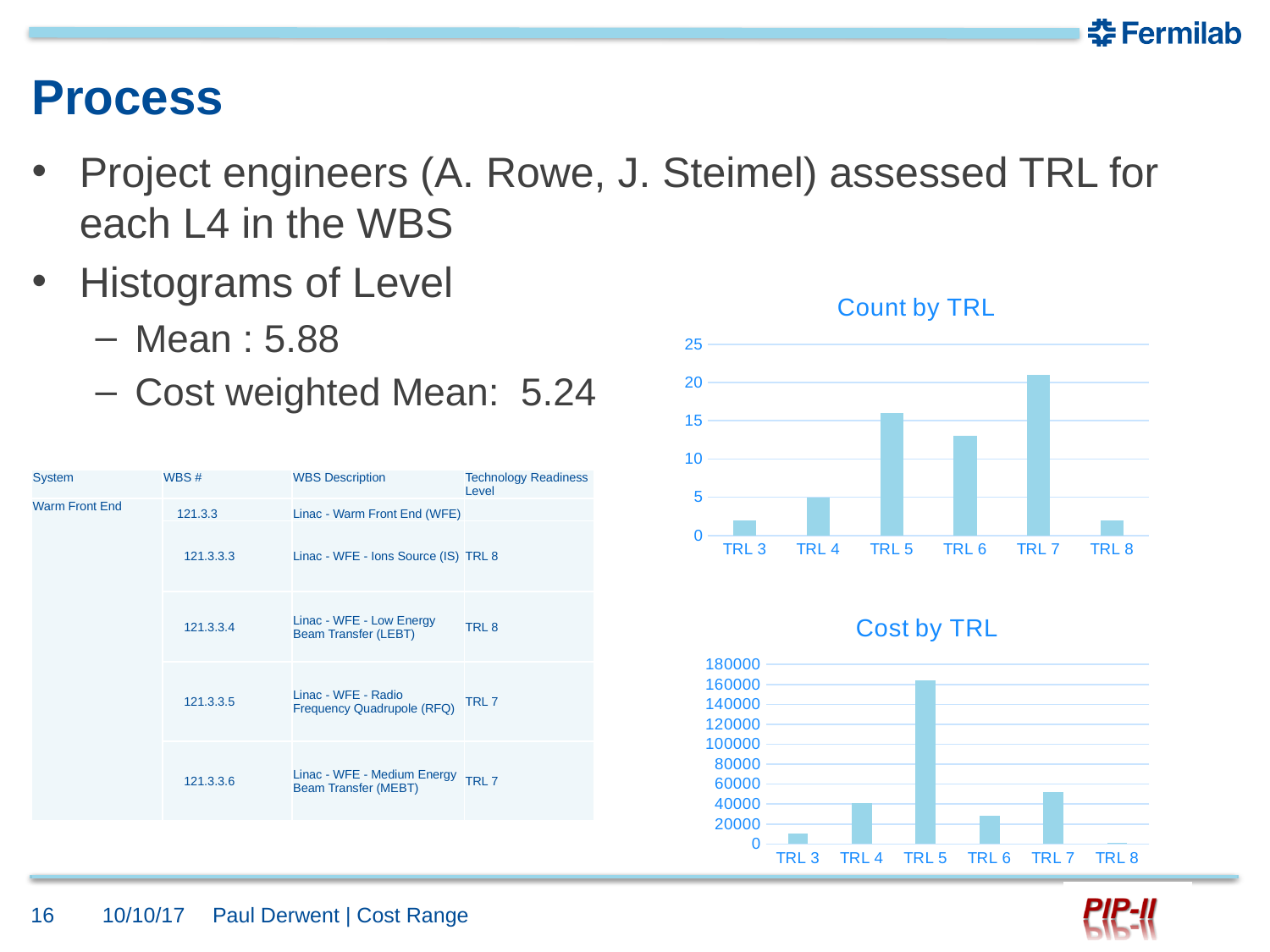
How many TRL categories are shown on the x axis of the "Count by TRL" chart? 6 In the "Count by TRL" chart, is the value for TRL 5 greater or less than 15? greater What kind of chart is the "Count by TRL" chart? bar chart In the "Cost by TRL" chart, is the value for TRL 5 greater or less than 160000? greater In the "Count by TRL" chart, which is larger, the count for TRL 5 or the count for TRL 6? TRL 5 In the "Cost by TRL" chart, which is larger, the cost for TRL 7 or the cost for TRL 6? TRL 7 In the "Cost by TRL" chart, which TRL category has the highest cost? TRL 5 In the "Count by TRL" chart, is the value for TRL 7 greater or less than 20? greater In the "Count by TRL" chart, which TRL category has the highest count? TRL 7 What is the title of the lower chart on the slide? Cost by TRL In the "Cost by TRL" chart, which TRL category has the lowest cost? TRL 8